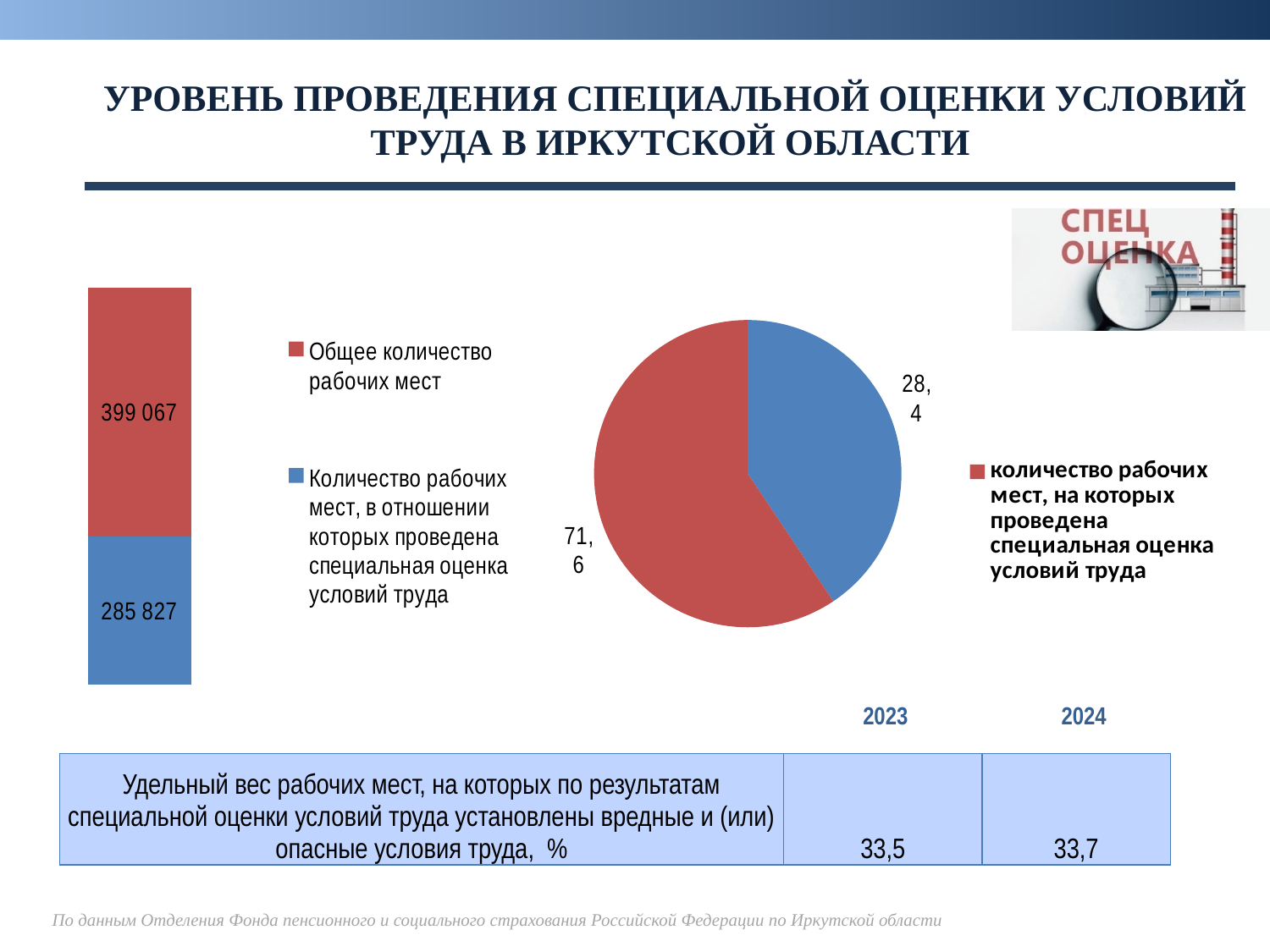
What kind of chart is the chart in the middle of the slide? Pie chart On the bar chart on the left, what is the value for "Общее количество рабочих мест"? 399 067 On the bar chart on the left, how many series does the legend list? 2 How many slices does the pie chart have? 2 On the pie chart, what is the value of the blue slice? 28,4 On the pie chart, what is the value of the red slice? 71,6 On the bar chart on the left, what is the value for "Количество рабочих мест, в отношении которых проведена специальная оценка условий труда"? 285 827 What kind of chart is the chart on the left of the slide? Bar chart On the bar chart on the left, what is the difference between 399 067 and 285 827? 113 240 On the bar chart on the left, which series has the larger value: "Общее количество рабочих мест" or "Количество рабочих мест, в отношении которых проведена специальная оценка условий труда"? Общее количество рабочих мест On the pie chart, which slice is larger: the red one or the blue one? Red On the bar chart on the left, what colour is the segment for "Общее количество рабочих мест"? Red